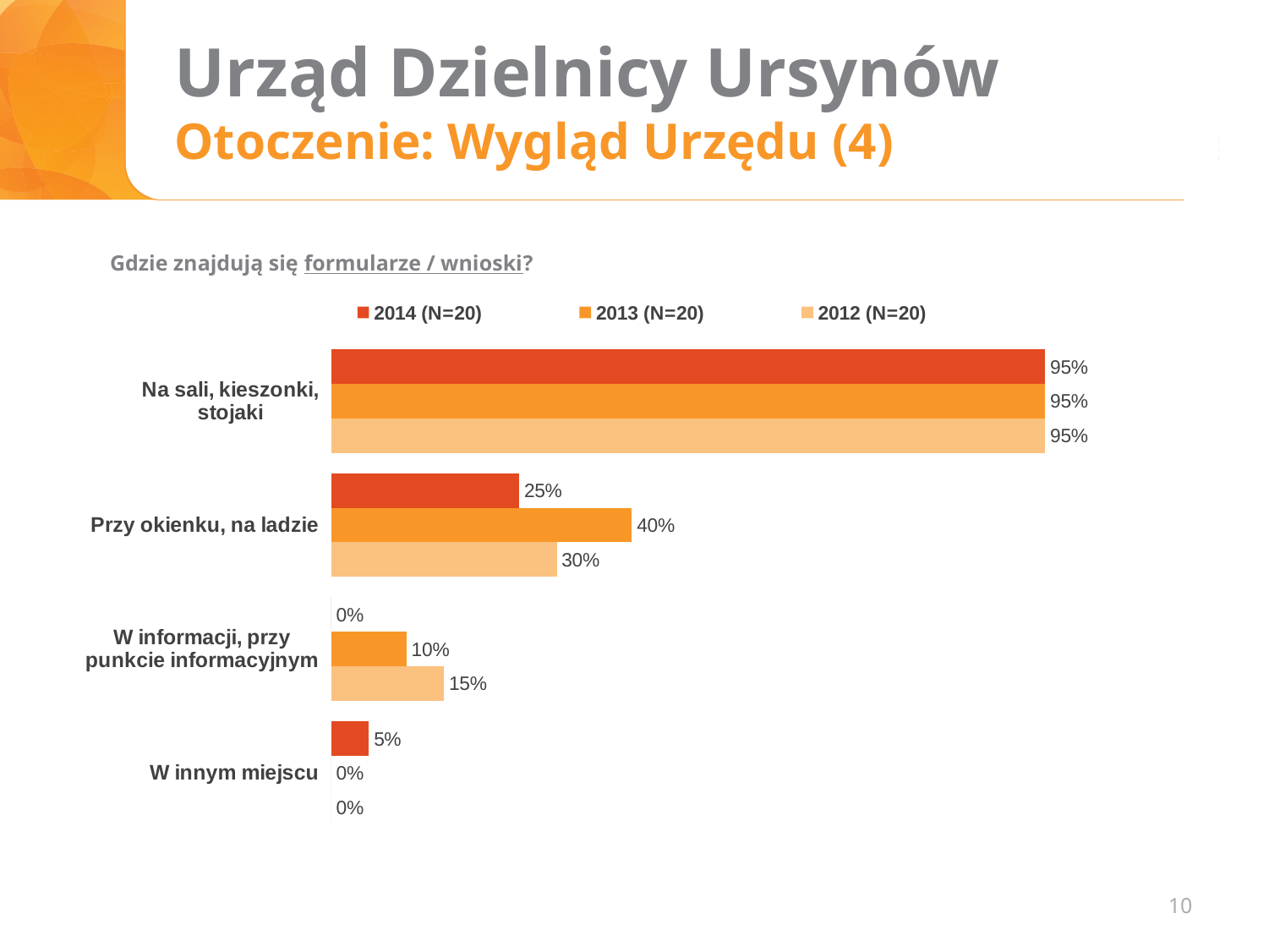
What is the difference between the 2013 (N=20) and 2014 (N=20) values for 'Przy okienku, na ladzie'? 15% What is the value for 'W informacji, przy punkcie informacyjnym' in the 2012 (N=20) series? 15% Which is larger for 'W informacji, przy punkcie informacyjnym': the 2013 (N=20) value or the 2012 (N=20) value? 2012 (N=20) How many categories are shown on the chart? 4 What question is the chart answering, as stated above the chart? Gdzie znajdują się formularze / wnioski? How many series does the legend list? 3 What is the value for 'W innym miejscu' in the 2014 (N=20) series? 5% What is the value for 'Na sali, kieszonki, stojaki' in the 2014 (N=20) series? 95% What type of chart is shown on the slide? bar chart What is the value for 'Przy okienku, na ladzie' in the 2013 (N=20) series? 40% Which category has the highest value in the 2013 (N=20) series? Na sali, kieszonki, stojaki Which category has the lowest value in the 2014 (N=20) series? W informacji, przy punkcie informacyjnym